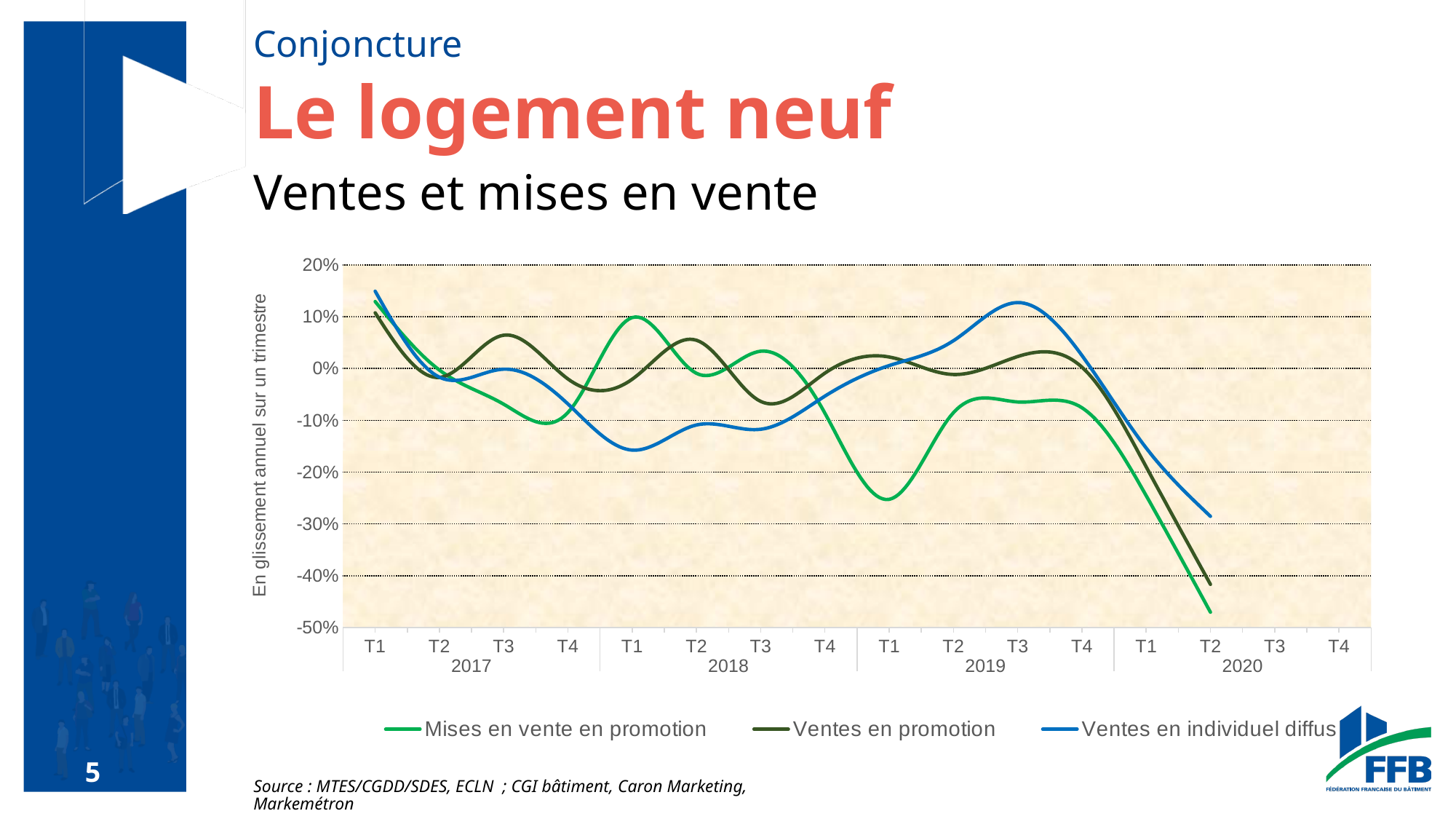
How many series does the legend list? 3 Is the value for Ventes en individuel diffus at T2 2020 greater or less than -20%? less Is the value for Mises en vente en promotion at T1 2019 greater or less than -20%? less What is the label on the vertical axis? En glissement annuel sur un trimestre What kind of chart is shown on the slide? line chart Do the three series rise or fall between T4 2019 and T2 2020? fall Is the value for Mises en vente en promotion at T2 2020 greater or less than -40%? less Which series has the lowest value at T2 2020? Mises en vente en promotion How many years are labelled along the x axis? 4 At T2 2020, which is higher: Ventes en individuel diffus or Mises en vente en promotion? Ventes en individuel diffus